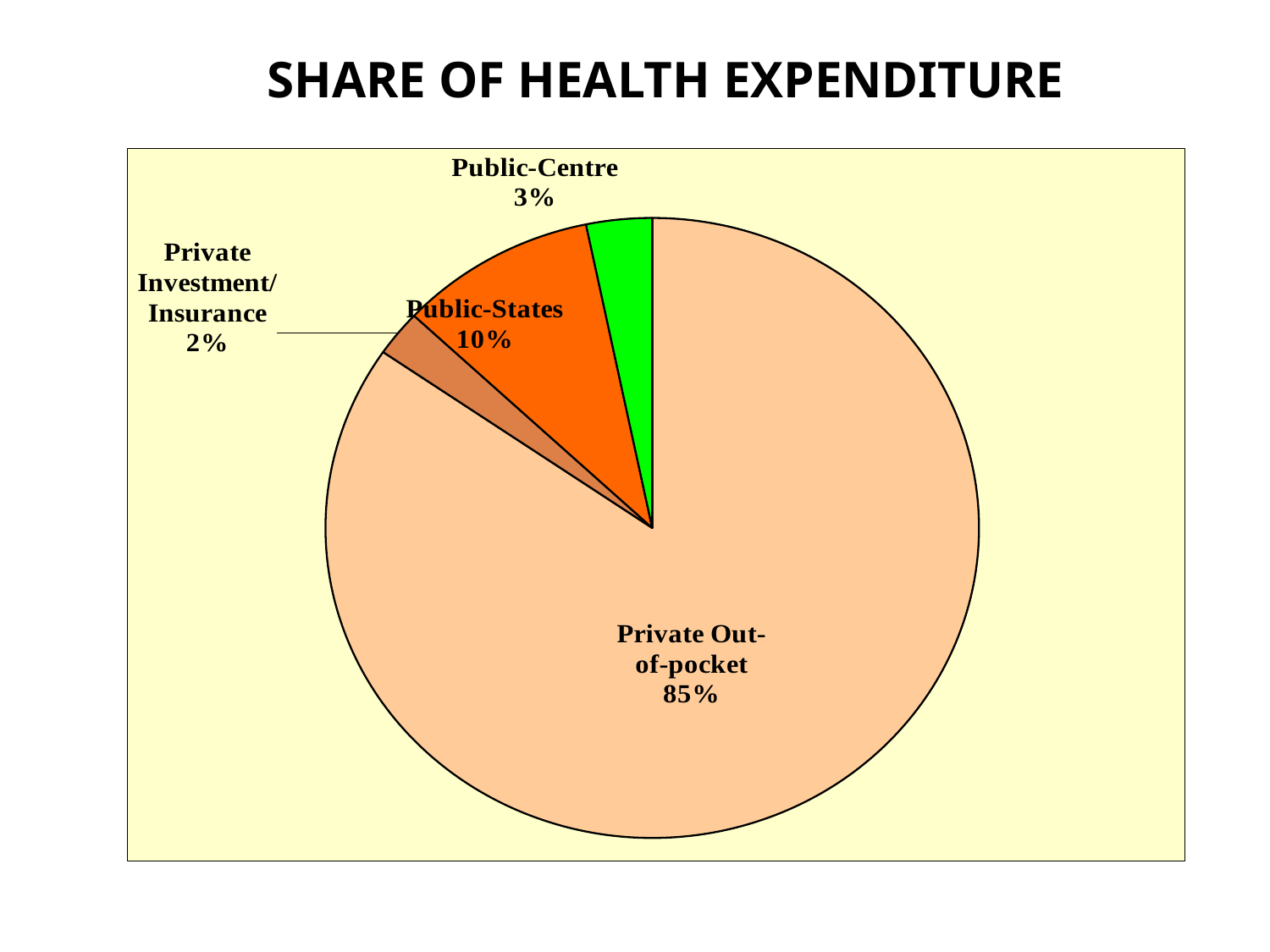
What share of health expenditure is Private Out-of-pocket? 85% Which category has the largest share of health expenditure? Private Out-of-pocket Which is larger, the Public-Centre share or the Private Investment/Insurance share? Public-Centre What is the title of the slide? SHARE OF HEALTH EXPENDITURE What is the combined share of Public-Centre and Public-States? 13% What kind of chart is shown on the slide? Pie chart How many slices does the pie chart have? 4 What share of health expenditure is Public-Centre? 3% What share of health expenditure is Private Investment/Insurance? 2% Which category has the smallest share of health expenditure? Private Investment/Insurance What is the difference in percentage points between the Public-States share and the Public-Centre share? 7 What share of health expenditure is Public-States? 10%